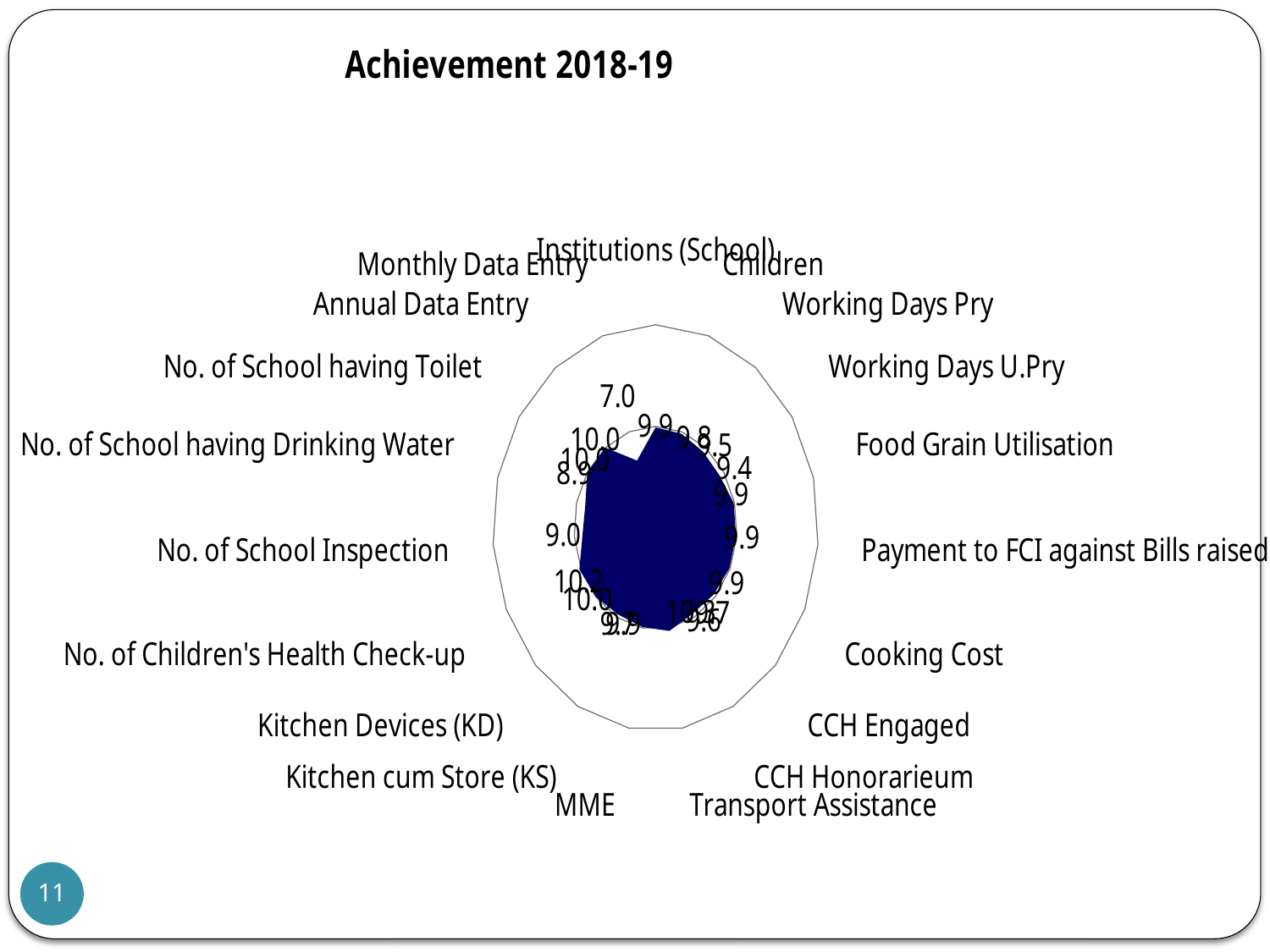
What colour is the filled area of the radar chart? Dark navy blue What is the difference between the value for No. of School Inspection and the value for Institutions (School)? 0.9 What is the title of the chart? Achievement 2018-19 Which category has the lowest value? Monthly Data Entry How many categories are plotted on the radar chart? 19 What is the value for Payment to FCI against Bills raised? 9.9 Which is larger, the value for No. of School Inspection or the value for Institutions (School)? Institutions (School) What is the value for No. of School Inspection? 9.0 What is the value for Institutions (School)? 9.9 Which is larger, the value for Payment to FCI against Bills raised or the value for Institutions (School)? Neither; both are 9.9 What kind of chart is shown on the slide? Radar chart